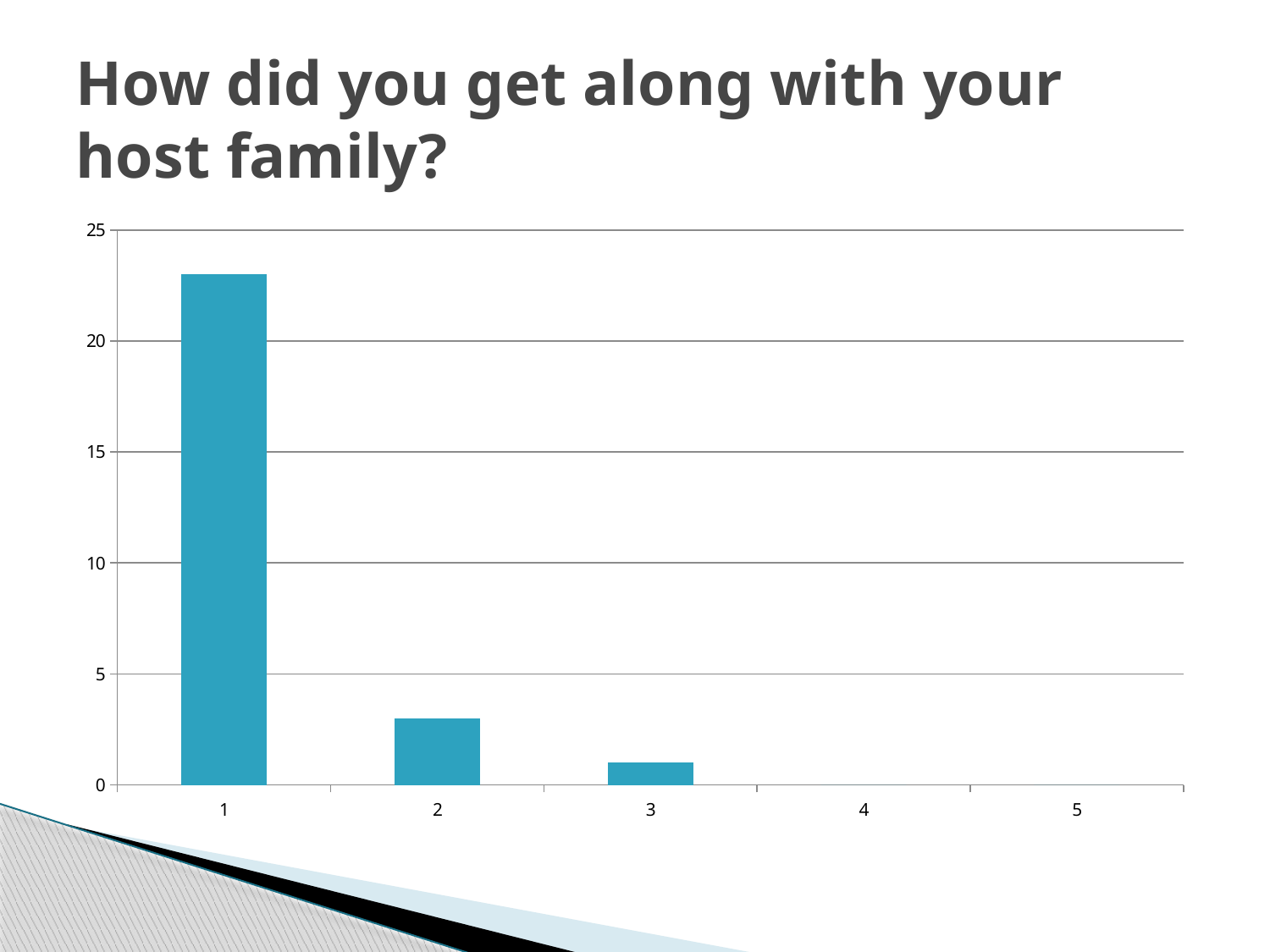
Is the value for category 1 greater or less than 25? less What is the title of the chart on the slide? How did you get along with your host family? Which has the larger value, category 1 or category 2? 1 How many categories are shown on the x axis of the chart? 5 How many categories in the chart have a visible bar? 3 Is the value for category 1 greater or less than 20? greater Which category has the highest value in the chart? 1 Is the value for category 3 greater or less than 5? less Do the values rise or fall moving from category 1 to category 5 along the x axis? fall What kind of chart is shown on the slide? bar chart Which has the larger value, category 2 or category 3? 2